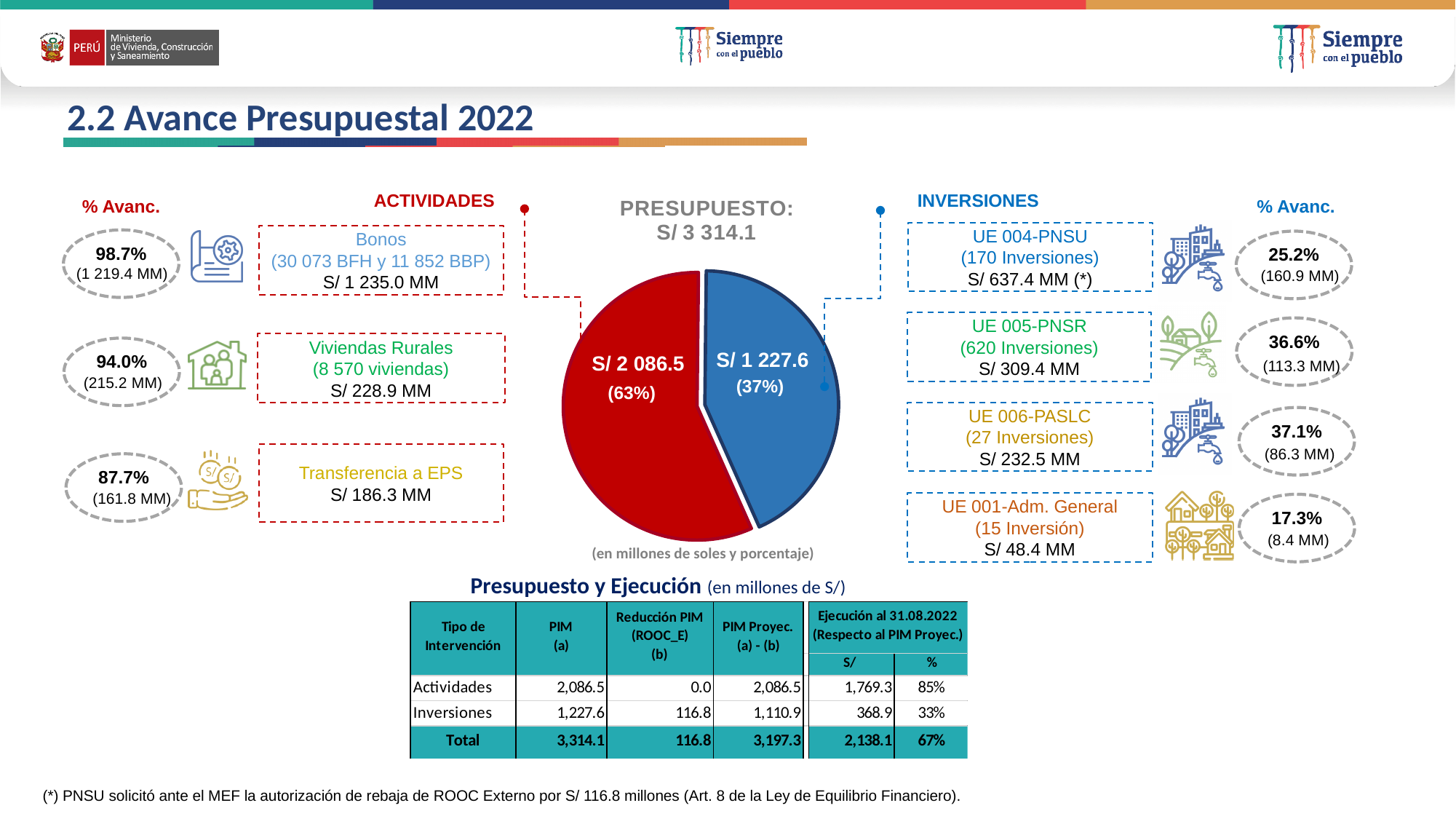
Which colour is used for the Inversiones slice of the pie chart? Blue Which slice of the pie chart is larger, the red one (Actividades) or the blue one (Inversiones)? The red one (Actividades) What value is printed on the blue slice of the pie chart? S/ 1 227.6 What value is printed on the red slice of the pie chart? S/ 2 086.5 What percentage share does the red slice (Actividades) represent in the pie chart? 63% What is the difference between the red slice value (S/ 2 086.5) and the blue slice value (S/ 1 227.6) in the pie chart? S/ 858.9 Which category has the smallest slice in the pie chart? Inversiones How many slices does the pie chart have? 2 According to the note below the pie chart, in what units are the values expressed? En millones de soles y porcentaje What percentage share does the blue slice (Inversiones) represent in the pie chart? 37% What total budget is shown in the heading above the pie chart? S/ 3 314.1 What kind of chart is shown in the centre of the slide under the heading 'PRESUPUESTO: S/ 3 314.1'? Pie chart